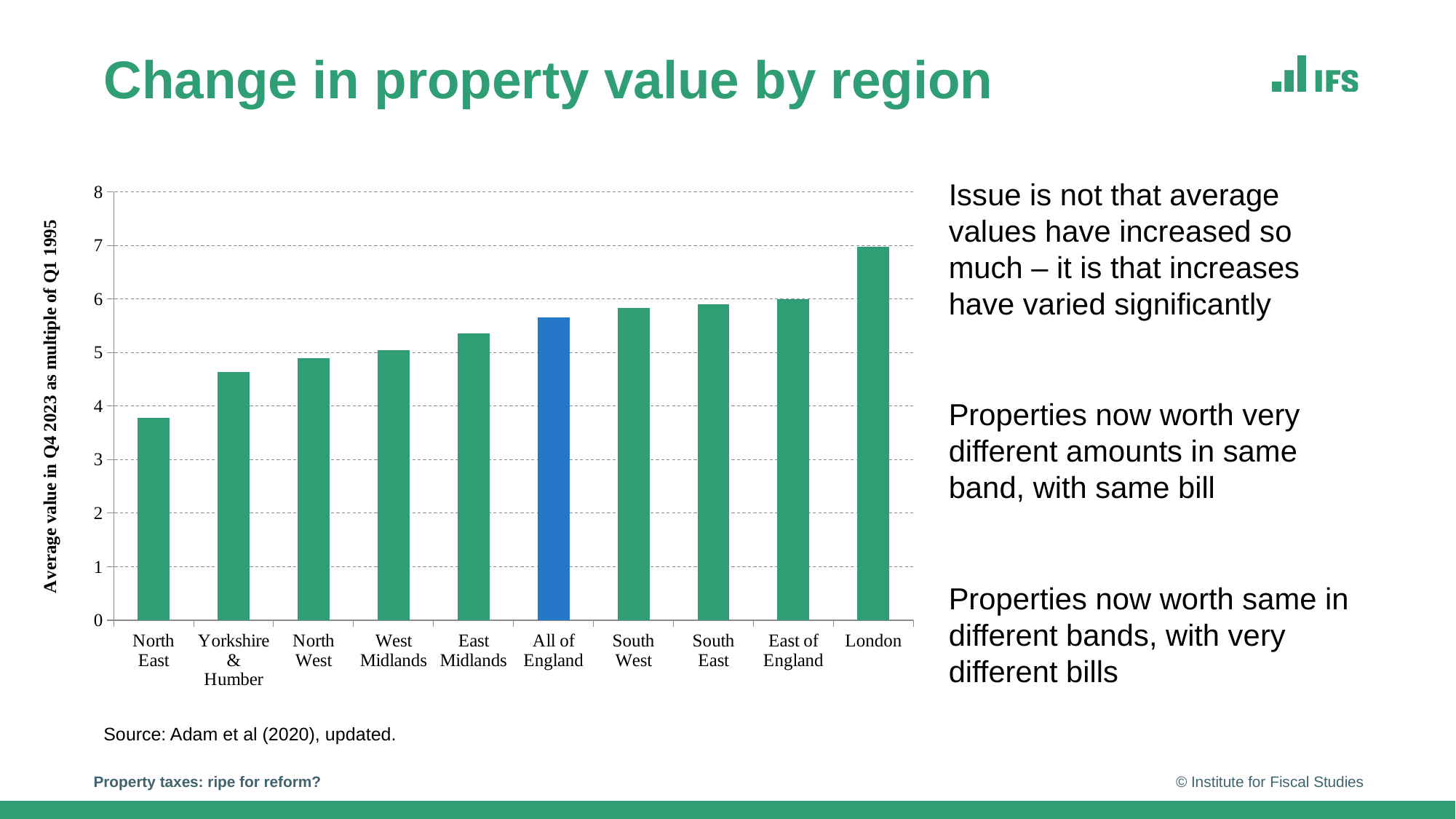
How many regions (bars) are plotted in the chart? 10 Is the value for All of England greater or less than 5? greater Which region has the highest average value in Q4 2023 as a multiple of Q1 1995? London Which bar is coloured blue rather than green? All of England Do the bar values generally rise or fall moving from left to right across the regions? Rise Which has a larger value, London or North East? London Which region has the lowest average value in Q4 2023 as a multiple of Q1 1995? North East Is the value for North West greater or less than 5? less Is the value for South West greater or less than 6? less What kind of chart is shown on the slide? Bar chart